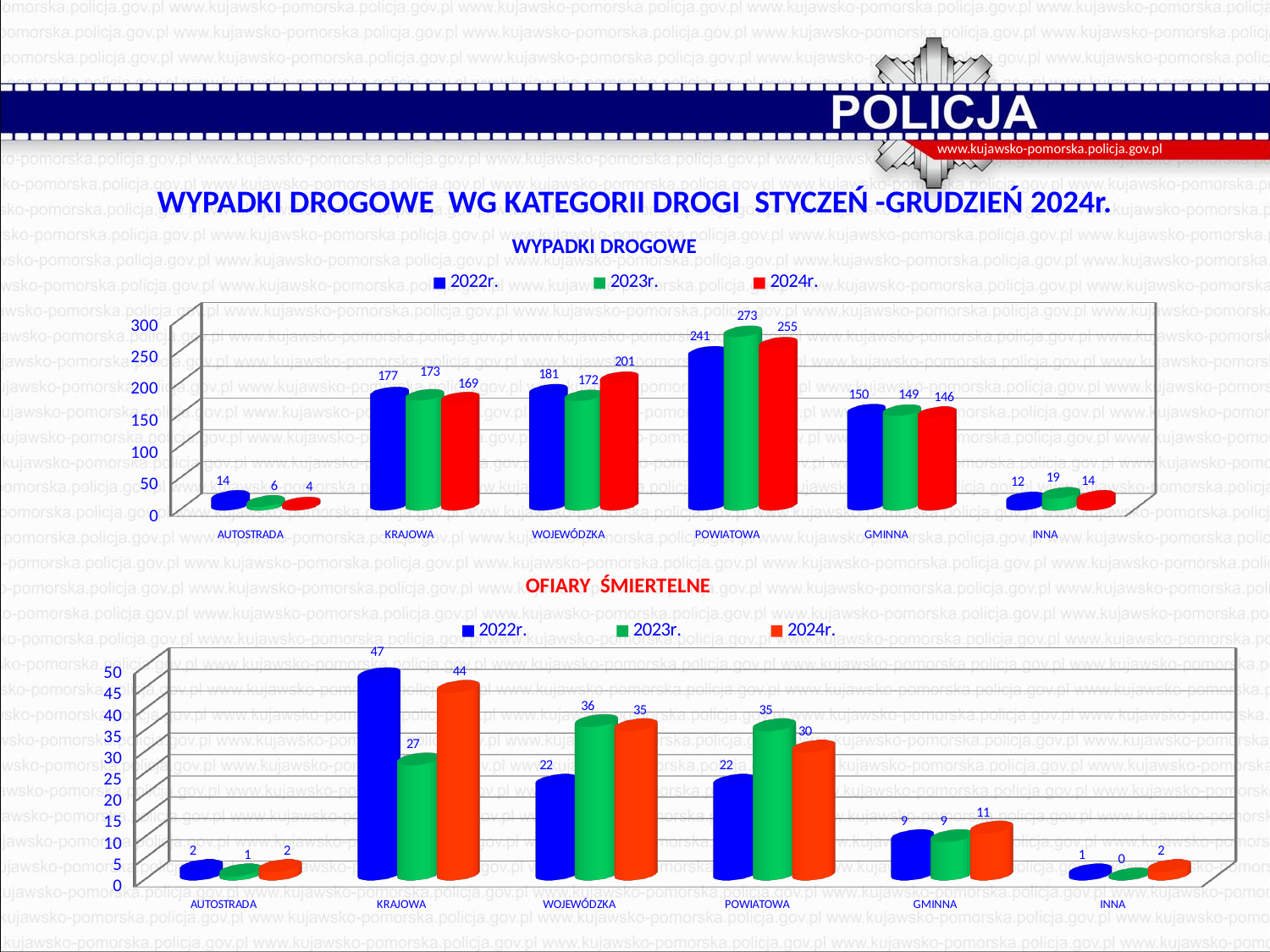
In the OFIARY ŚMIERTELNE chart, what is the value for INNA in 2023r.? 0 How many series does the legend of the OFIARY ŚMIERTELNE chart list? 3 In the OFIARY ŚMIERTELNE chart, which is larger for WOJEWÓDZKA: the 2022r. value or the 2023r. value? 2023r. In the WYPADKI DROGOWE chart, what is the value for WOJEWÓDZKA in 2024r.? 201 In the OFIARY ŚMIERTELNE chart, what is the difference between the 2022r. and 2023r. values for KRAJOWA? 20 What type of chart is the WYPADKI DROGOWE chart? Bar chart In the WYPADKI DROGOWE chart, which category has the highest value for 2022r.? POWIATOWA In the WYPADKI DROGOWE chart, how many categories are shown on the x axis? 6 In the WYPADKI DROGOWE chart, which category has the lowest value for 2024r.? AUTOSTRADA In the OFIARY ŚMIERTELNE chart, what is the value for KRAJOWA in 2022r.? 47 In the WYPADKI DROGOWE chart, what is the value for POWIATOWA in 2023r.? 273 In the WYPADKI DROGOWE chart, what is the difference between the 2023r. and 2022r. values for POWIATOWA? 32